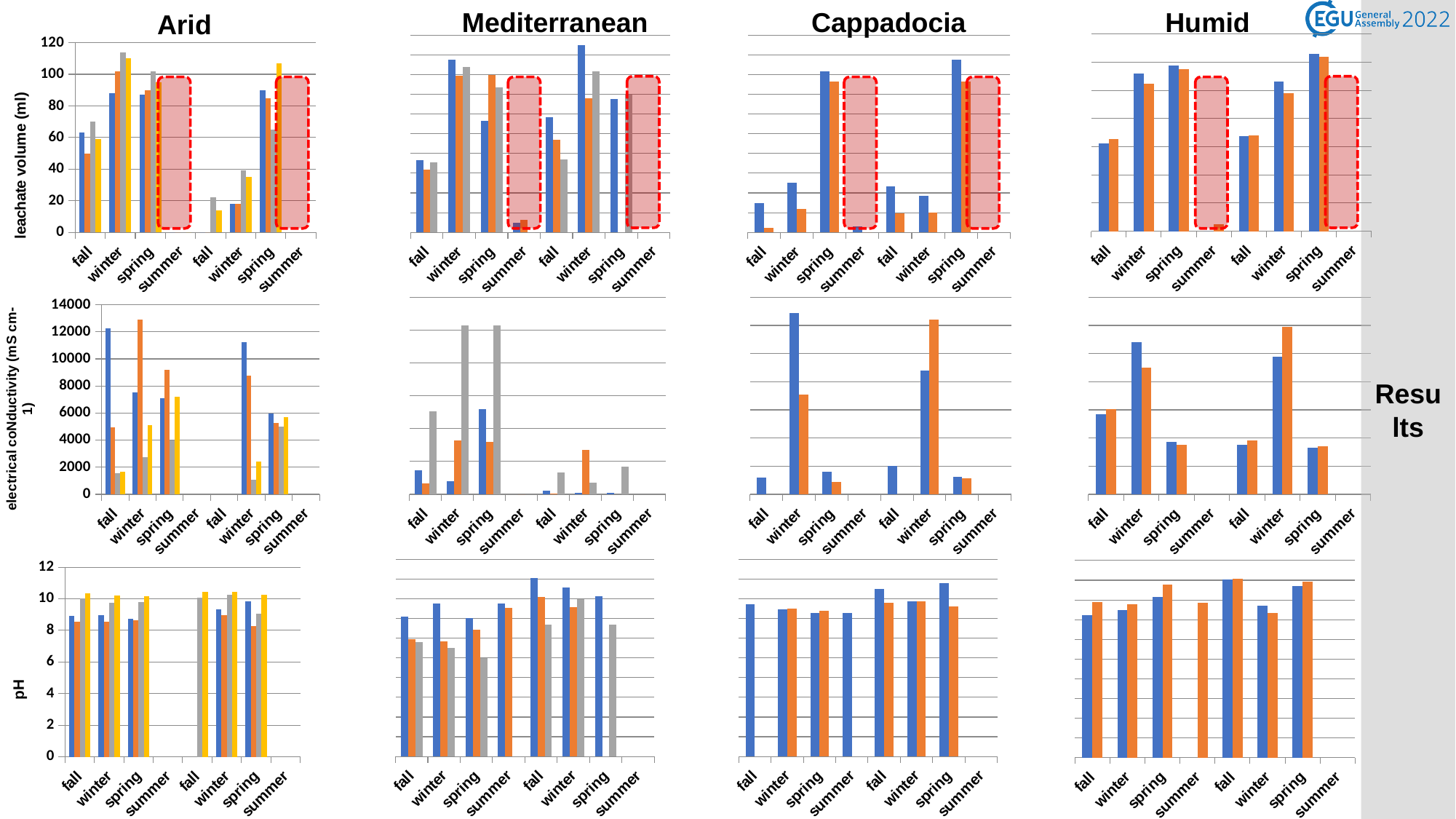
How many categories are on the x axis of the Humid pH chart (bottom-right)? 8 What kind of chart is the Arid leachate volume chart (top-left)? bar chart In the Cappadocia leachate volume chart (top row), is the blue bar at the second spring greater or less than 100? greater What are the four column titles above the charts? Arid, Mediterranean, Cappadocia, Humid How many charts are shown on the slide? 12 In the Mediterranean leachate volume chart (top row), is the tallest blue bar at the second winter greater or less than 100? greater In the Mediterranean leachate volume chart (top row), at which category is the highest bar? winter (second) In the Humid leachate volume chart (top row), which has the larger blue bar: the first fall or the second spring? spring In the Arid leachate volume chart (top row), which has the larger blue bar: the first fall or the first winter? winter In the Arid electrical conductivity chart (middle row), is the blue bar at the first fall greater or less than 10000? greater